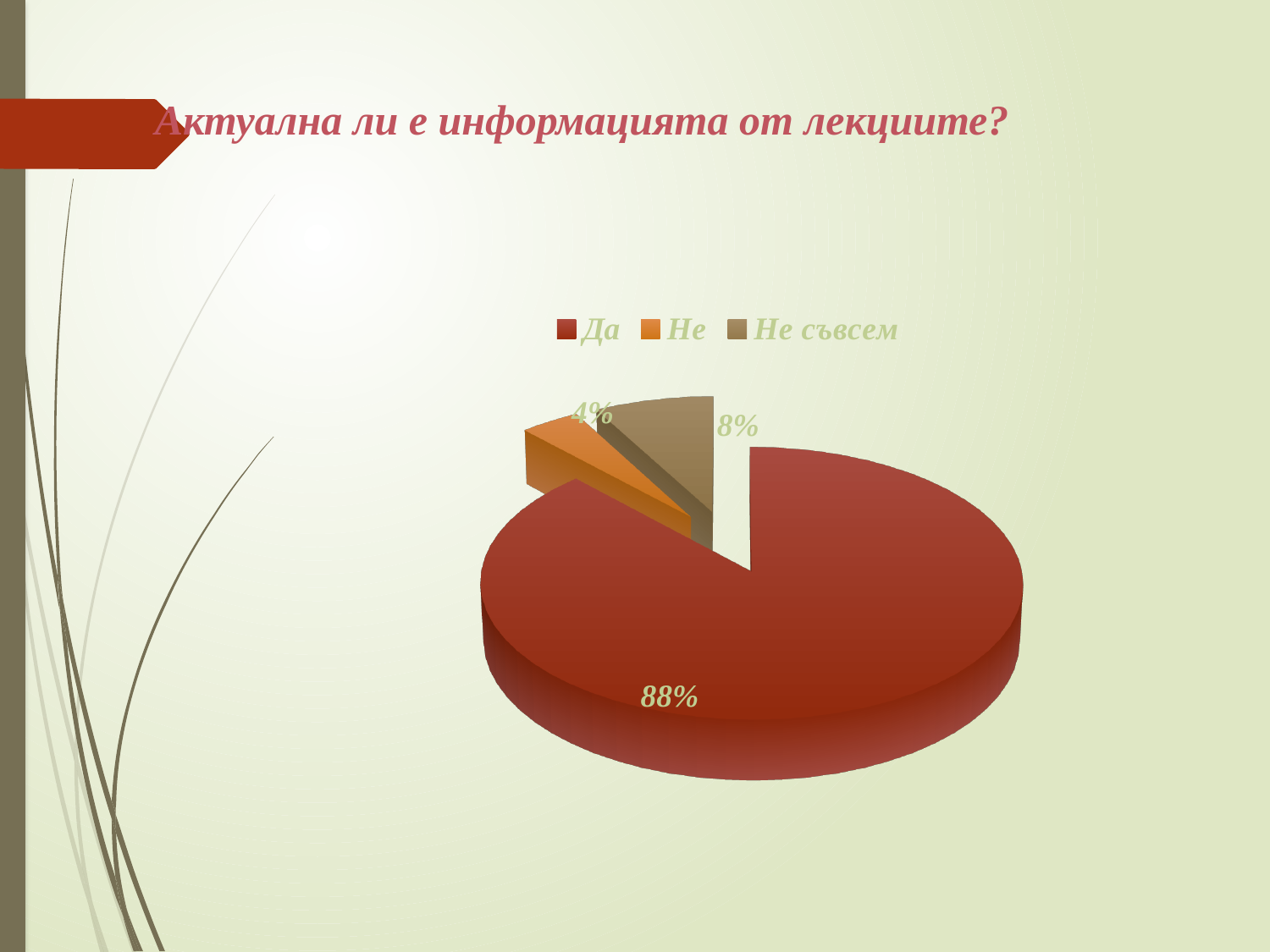
Which category has the smallest slice of the pie? Не What share of the pie does "Не" have? 4% What share of the pie does "Да" have? 88% How many categories does the pie chart have? 3 What share of the pie does "Не съвсем" have? 8% What is the difference in percentage points between "Да" and "Не съвсем"? 80 Which is larger, the slice for "Не" or the slice for "Не съвсем"? Не съвсем What is the difference in percentage points between "Не съвсем" and "Не"? 4 What kind of chart is shown on the slide? pie chart What colour is the slice for "Не" in the pie chart? orange What is the title of the slide above the chart? Актуална ли е информацията от лекциите? Which category has the largest slice of the pie? Да